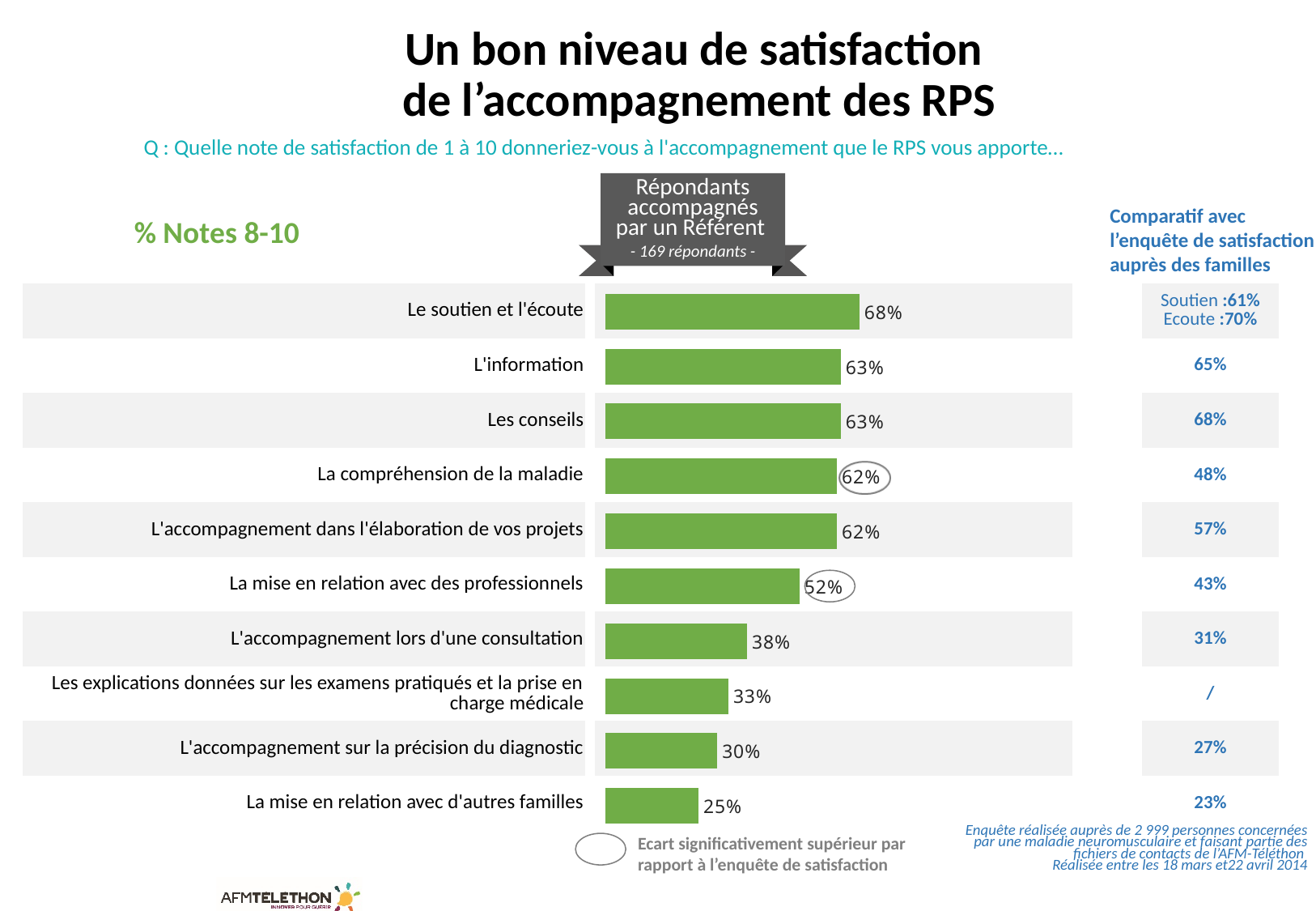
Do the values rise or fall going from the top category to the bottom category? Fall How many respondents does the chart say were surveyed ("Répondants accompagnés par un Référent")? 169 répondants What type of chart is used on this slide? Bar chart Which category has the highest percentage of scores 8-10? Le soutien et l'écoute What is the difference between the values for "Le soutien et l'écoute" and "La mise en relation avec d'autres familles"? 43 percentage points Which category has the lowest percentage of scores 8-10? La mise en relation avec d'autres familles What percentage of respondents gave a score of 8-10 for "Le soutien et l'écoute"? 68% What is the value shown for "La mise en relation avec des professionnels"? 52% What is the difference between the values for "L'information" and "La compréhension de la maladie"? 1 percentage point What is the value shown for "L'accompagnement sur la précision du diagnostic"? 30% Which is larger: the value for "L'accompagnement lors d'une consultation" or the value for "Les explications données sur les examens pratiqués et la prise en charge médicale"? L'accompagnement lors d'une consultation How many categories are shown in the bar chart? 10